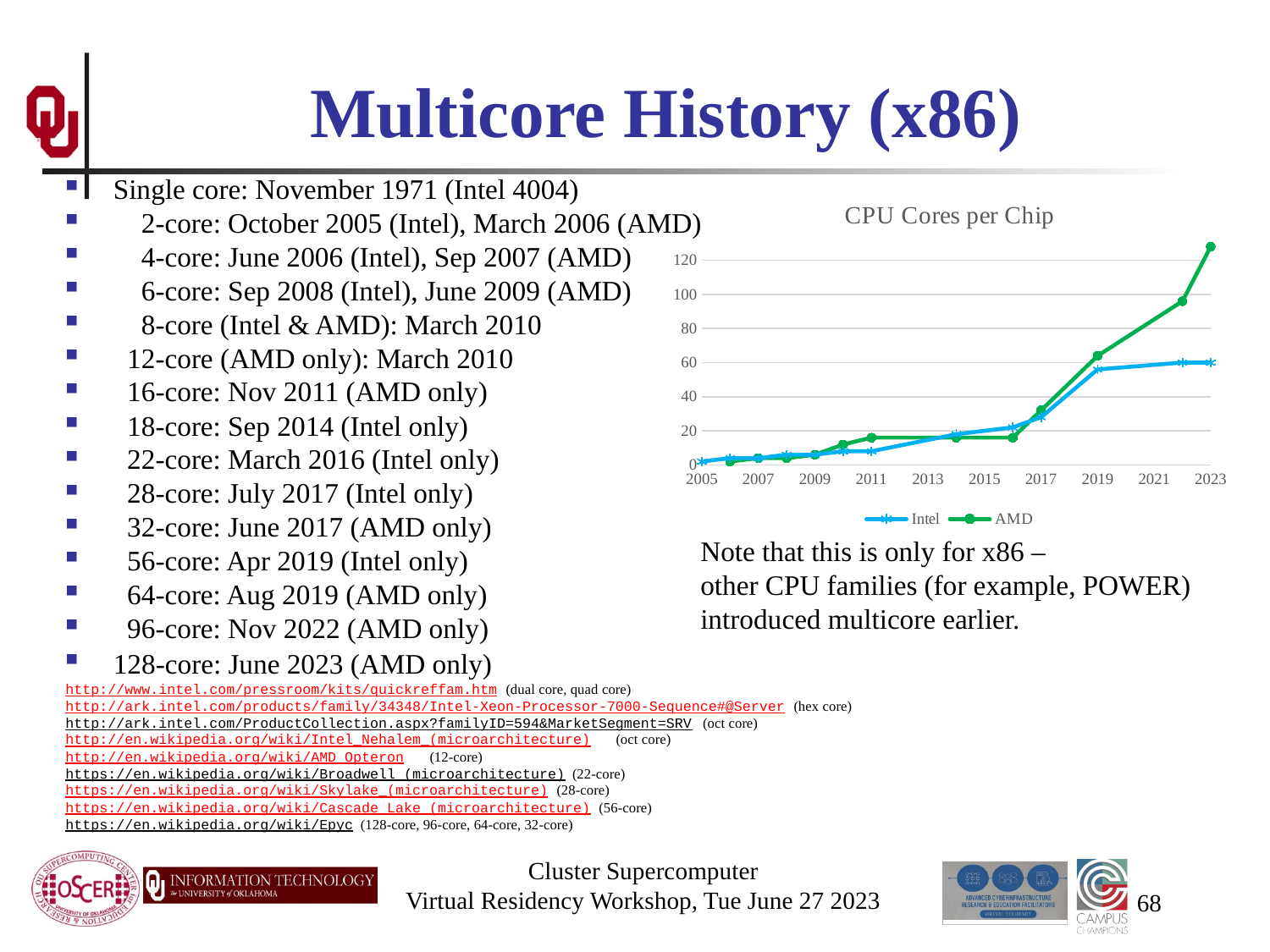
Is the AMD value for 2009 greater or less than 20? less Is the AMD value for 2019 greater or less than 40? greater Is the Intel value for 2017 greater or less than 20? greater Which series has the higher value in 2019, Intel or AMD? AMD What is the title of the chart on the slide? CPU Cores per Chip Which series has the higher value in 2023, Intel or AMD? AMD Which two series are shown in the chart's legend? Intel and AMD What kind of chart is shown on the slide? line chart How many series does the chart's legend list? 2 Do the AMD values generally rise or fall from 2005 to 2023? rise